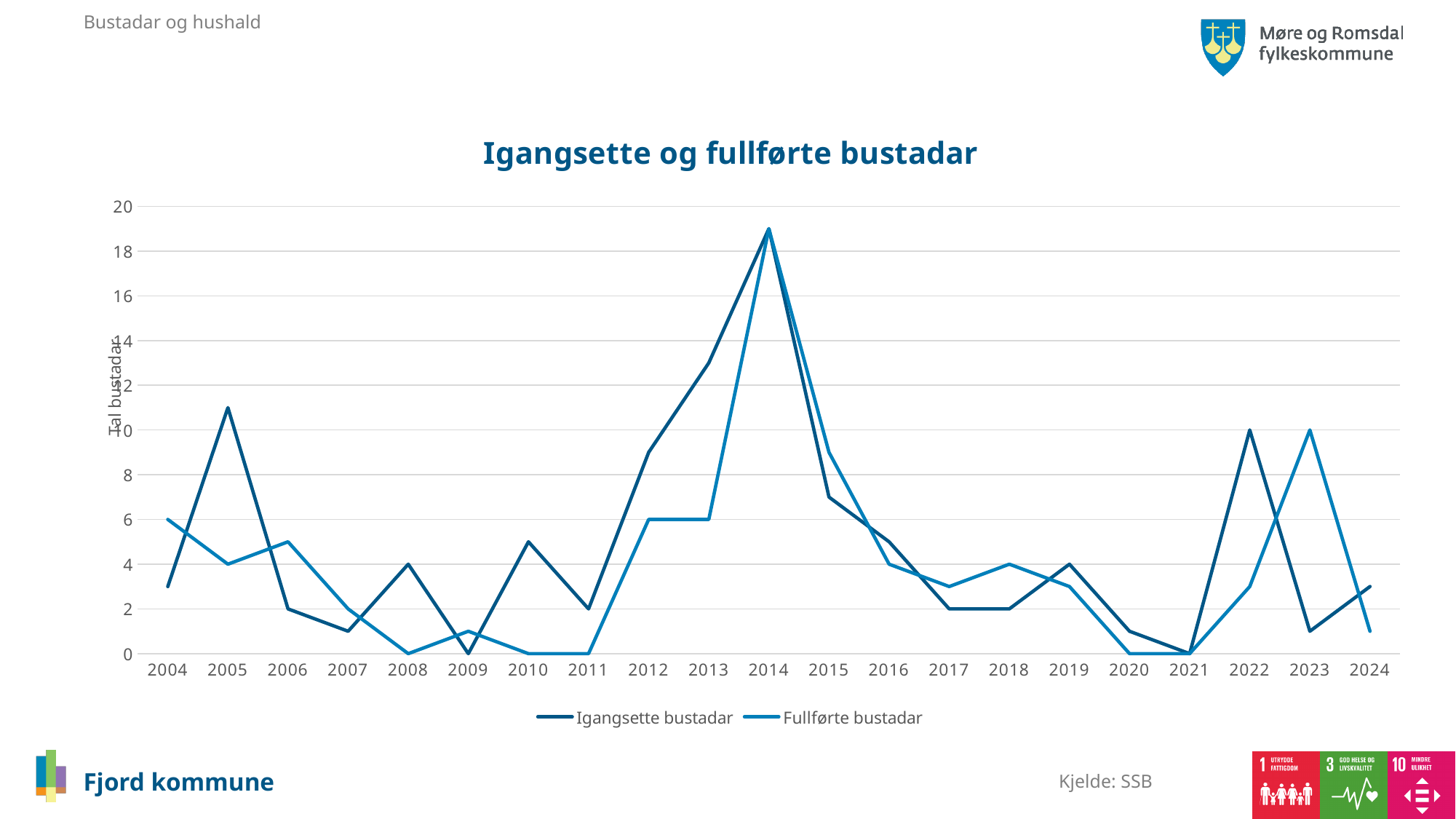
What is the value of Igangsette bustadar in 2022? 10 What is the value of Fullførte bustadar in 2004? 6 Is the value for Igangsette bustadar in 2014 greater or less than 18? greater What kind of chart is shown on the slide? line chart Does the Igangsette bustadar series rise or fall from 2014 to 2017? fall How many years are shown on the x axis? 21 What is the value of Fullførte bustadar in 2023? 10 In which year does the Igangsette bustadar series reach its highest value? 2014 How many series does the legend list? 2 Which series has the larger value in 2005, Igangsette bustadar or Fullførte bustadar? Igangsette bustadar What is the difference between Fullførte bustadar in 2004 and in 2005? 2 What is the value of Igangsette bustadar in 2009? 0